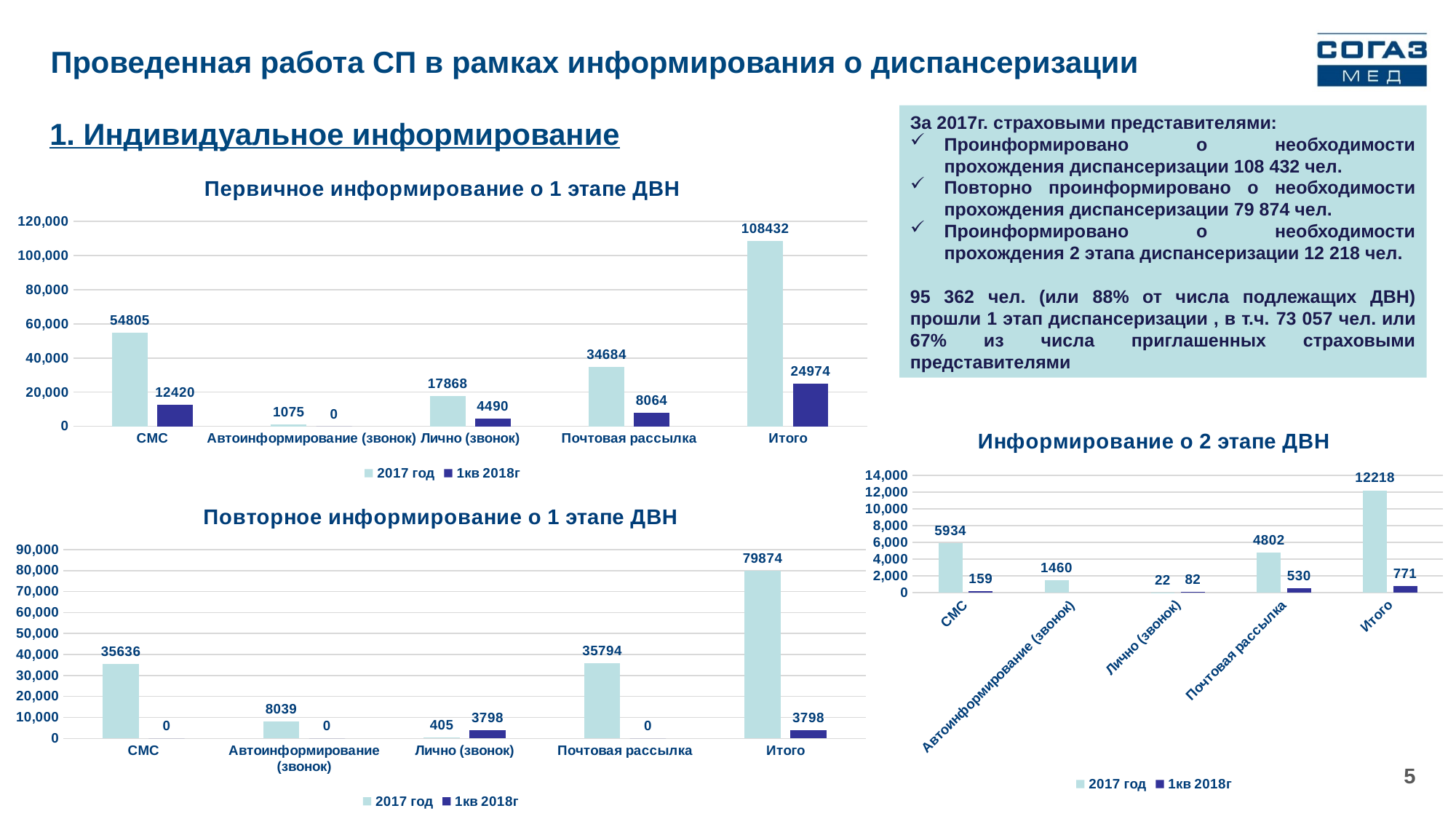
How many series does the legend of the chart 'Информирование о 2 этапе ДВН' list? 2 In the chart 'Повторное информирование о 1 этапе ДВН', what is the value for Лично (звонок) in the '1кв 2018г' series? 3798 In the chart 'Первичное информирование о 1 этапе ДВН', what is the value for Почтовая рассылка in the '1кв 2018г' series? 8064 In the chart 'Информирование о 2 этапе ДВН', what is the difference between the 2017 год values for СМС and Почтовая рассылка? 1132 In the chart 'Повторное информирование о 1 этапе ДВН', what is the value for Автоинформирование (звонок) in the '2017 год' series? 8039 In the chart 'Информирование о 2 этапе ДВН', which is larger for Почтовая рассылка: the 2017 год value or the 1кв 2018г value? 2017 год In the chart 'Первичное информирование о 1 этапе ДВН', which category other than Итого has the lowest 2017 год value? Автоинформирование (звонок) In the chart 'Первичное информирование о 1 этапе ДВН', what is the difference between the 2017 год values for СМС and Почтовая рассылка? 20121 In the chart 'Повторное информирование о 1 этапе ДВН', how many categories are shown on the x axis? 5 In the chart 'Первичное информирование о 1 этапе ДВН', what is the value for СМС in the '2017 год' series? 54805 What type of chart is 'Повторное информирование о 1 этапе ДВН'? Bar chart In the chart 'Информирование о 2 этапе ДВН', what is the value for Итого in the '2017 год' series? 12218